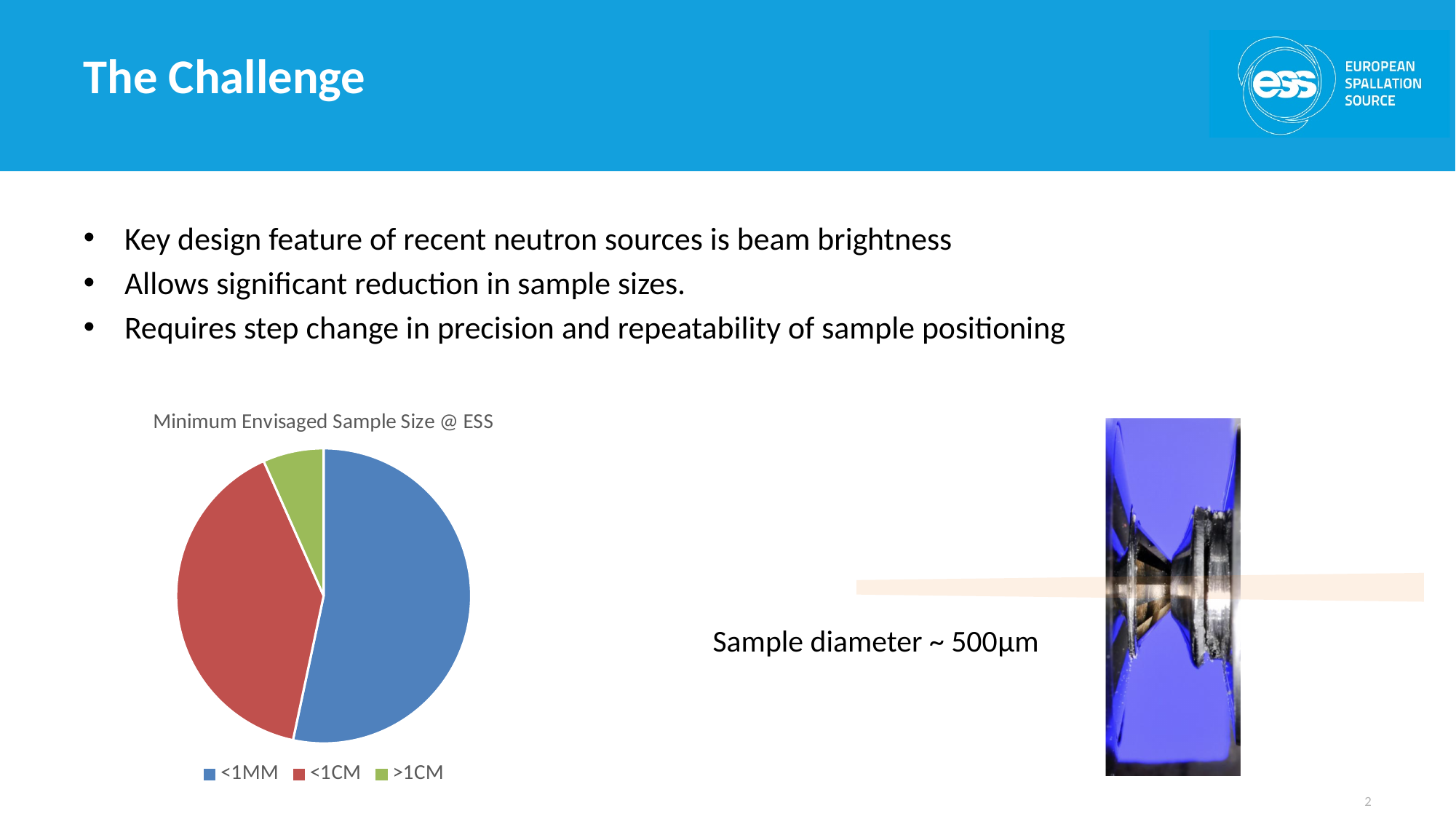
Which category has the largest slice in the pie chart? <1MM Which slice is larger in the pie chart, <1MM or <1CM? <1MM Which category has the smallest slice in the pie chart? >1CM What kind of chart is shown on the slide? pie chart What is the title of the pie chart? Minimum Envisaged Sample Size @ ESS Which slice is larger in the pie chart, <1CM or >1CM? <1CM Which category in the pie chart is shown in green? >1CM How many slices does the pie chart have? 3 How many entries does the legend of the pie chart list? 3 What colour is the <1CM slice in the pie chart? red